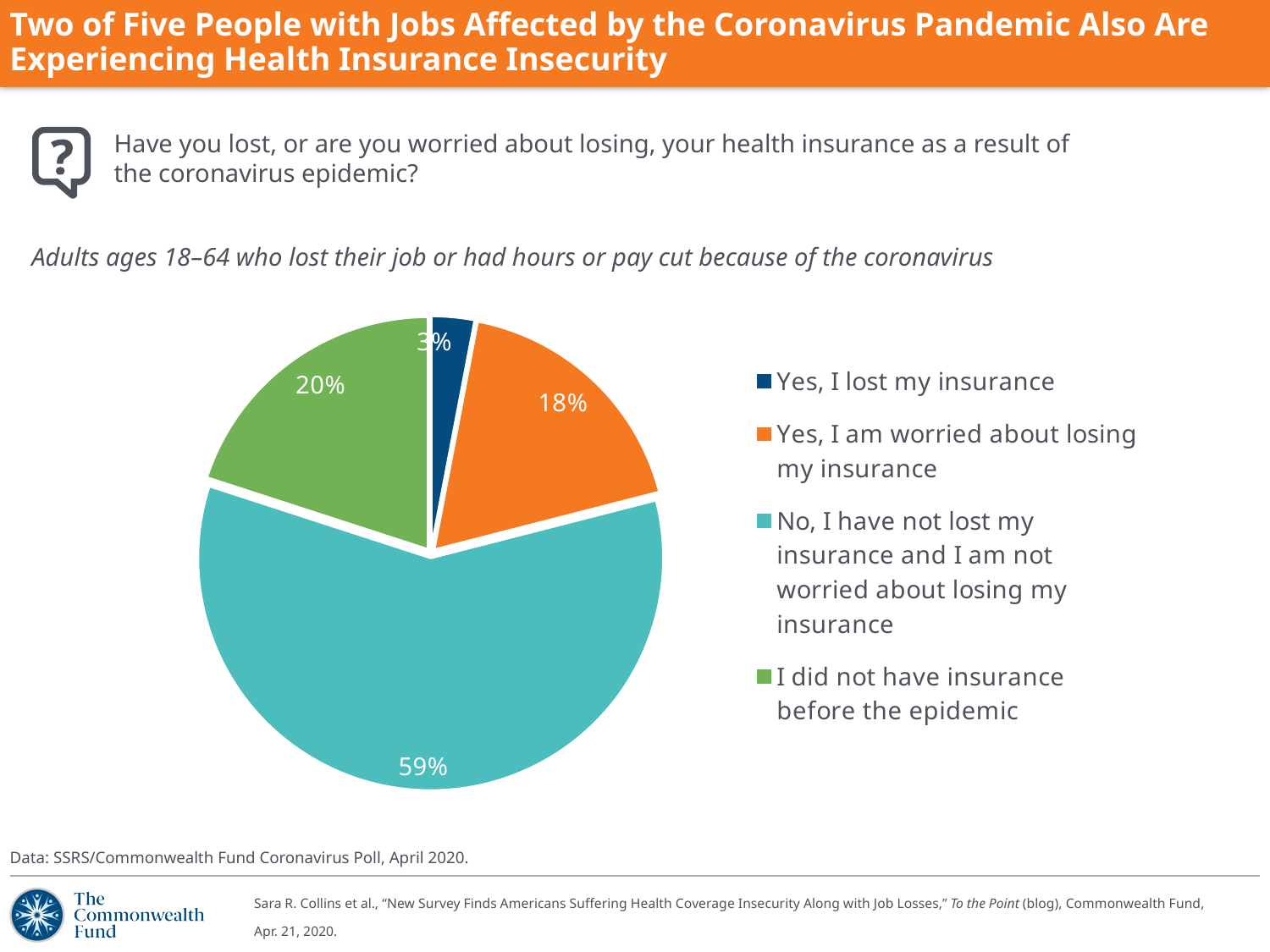
How many slices does the pie chart have? 4 What share of respondents said "Yes, I am worried about losing my insurance"? 18% Which response has the smallest slice of the pie? Yes, I lost my insurance What is the combined share of respondents who either lost their insurance or are worried about losing it? 21% What share of respondents said "I did not have insurance before the epidemic"? 20% What is the difference in percentage points between the "I did not have insurance before the epidemic" slice and the "Yes, I am worried about losing my insurance" slice? 2 percentage points What colour is the slice for "Yes, I am worried about losing my insurance"? orange Which is larger: the share who did not have insurance before the epidemic or the share worried about losing their insurance? I did not have insurance before the epidemic What share of respondents said "Yes, I lost my insurance"? 3% Which response has the largest slice of the pie? No, I have not lost my insurance and I am not worried about losing my insurance What share of respondents said "No, I have not lost my insurance and I am not worried about losing my insurance"? 59% What kind of chart is shown on the slide? pie chart